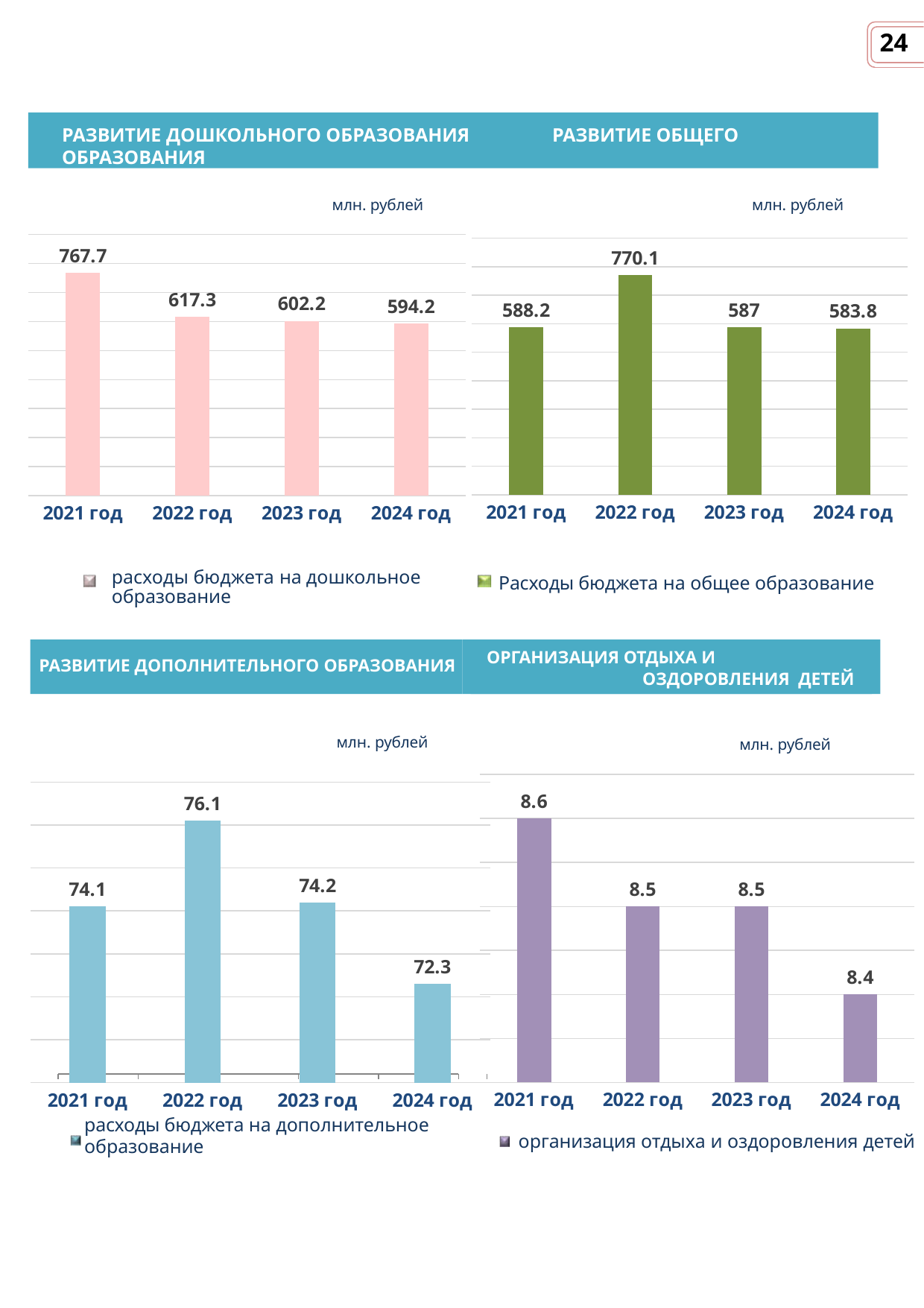
In the top-right chart (РАЗВИТИЕ ОБЩЕГО ОБРАЗОВАНИЯ), what is the value for 2023 год? 587 In the top-right chart (РАЗВИТИЕ ОБЩЕГО ОБРАЗОВАНИЯ), what is the difference between the values for 2022 год and 2024 год? 186.3 In the top-left chart (РАЗВИТИЕ ДОШКОЛЬНОГО ОБРАЗОВАНИЯ), what is the value for 2021 год? 767.7 In the top-right chart (РАЗВИТИЕ ОБЩЕГО ОБРАЗОВАНИЯ), which year has the highest value? 2022 год In the bottom-right chart (ОРГАНИЗАЦИЯ ОТДЫХА И ОЗДОРОВЛЕНИЯ ДЕТЕЙ), what unit is stated above the chart? млн. рублей In the top-left chart (РАЗВИТИЕ ДОШКОЛЬНОГО ОБРАЗОВАНИЯ), which year has the lowest value? 2024 год In the bottom-right chart (ОРГАНИЗАЦИЯ ОТДЫХА И ОЗДОРОВЛЕНИЯ ДЕТЕЙ), what is the value for 2024 год? 8.4 In the bottom-left chart (РАЗВИТИЕ ДОПОЛНИТЕЛЬНОГО ОБРАЗОВАНИЯ), which is larger, the value for 2022 год or 2024 год? 2022 год In the top-left chart (РАЗВИТИЕ ДОШКОЛЬНОГО ОБРАЗОВАНИЯ), what is the difference between the values for 2021 год and 2024 год? 173.5 What kind of chart is the top-right chart (РАЗВИТИЕ ОБЩЕГО ОБРАЗОВАНИЯ)? Bar chart In the bottom-left chart (РАЗВИТИЕ ДОПОЛНИТЕЛЬНОГО ОБРАЗОВАНИЯ), what is the value for 2022 год? 76.1 In the bottom-right chart (ОРГАНИЗАЦИЯ ОТДЫХА И ОЗДОРОВЛЕНИЯ ДЕТЕЙ), how many years are shown on the x axis? 4